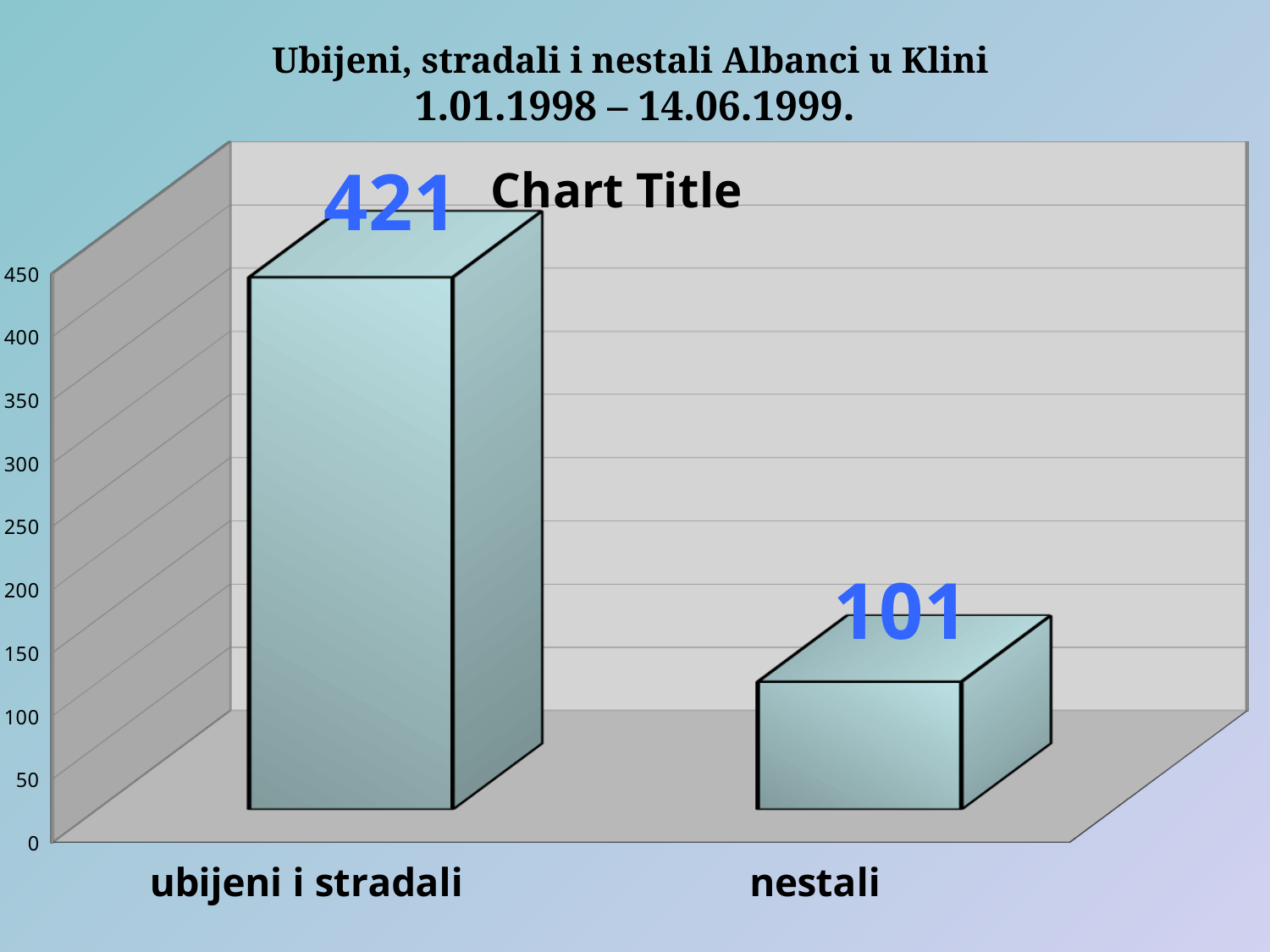
What is the value for "nestali"? 101 What is the value for "ubijeni i stradali"? 421 What is the highest value shown on the vertical axis? 450 Is the value for "ubijeni i stradali" greater or less than 400? greater What is the title printed inside the chart area? Chart Title How many categories are shown in the chart? 2 What kind of chart is shown on the slide? bar chart What is the difference between the values for "ubijeni i stradali" and "nestali"? 320 Which category has the lowest value? nestali Which category has the highest value? ubijeni i stradali Which is larger, the value for "ubijeni i stradali" or the value for "nestali"? ubijeni i stradali Is the value for "nestali" greater or less than 150? less